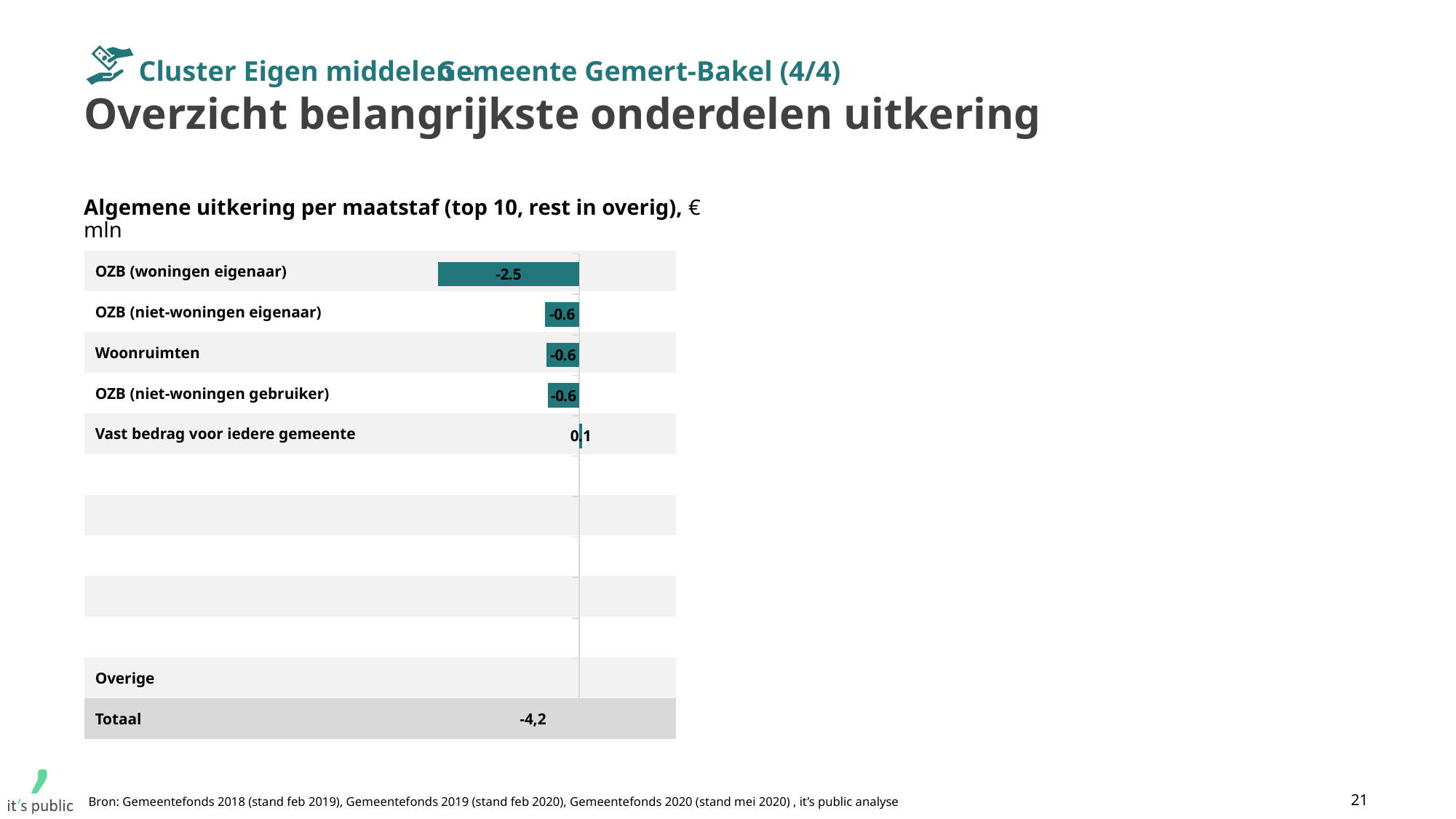
What is the difference between the values for OZB (woningen eigenaar) and Woonruimten? 1.9 What is the value for Woonruimten? -0.6 What is the title of the chart? Algemene uitkering per maatstaf (top 10, rest in overig), € mln Which is larger, the value for Vast bedrag voor iedere gemeente or the value for OZB (woningen eigenaar)? Vast bedrag voor iedere gemeente What kind of chart is shown on the slide? Bar chart Which category has the highest value? Vast bedrag voor iedere gemeente What is the value for OZB (niet-woningen eigenaar)? -0.6 How many categories have a value of -0.6? 3 What is the value shown for Totaal? -4,2 Which category has the lowest (most negative) value? OZB (woningen eigenaar) What is the value for OZB (niet-woningen gebruiker)? -0.6 What is the value for OZB (woningen eigenaar)? -2.5